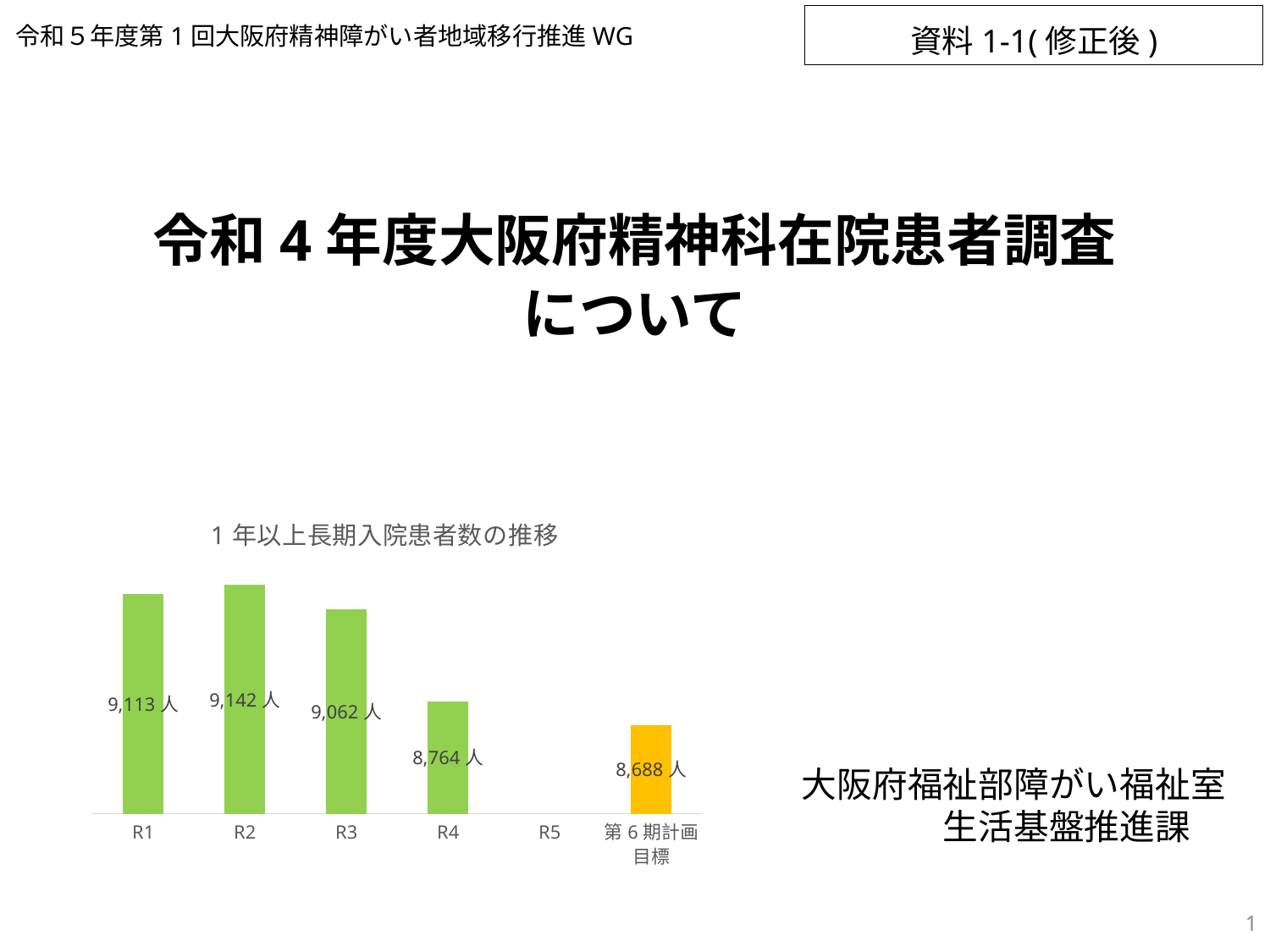
What kind of chart is shown on the slide? Bar chart What is the value shown for 第6期計画目標 in the chart? 8,688人 Which category with a plotted bar has the lowest value in the chart? 第6期計画目標 What is the value for R2 in the chart? 9,142人 What is the value for R1 in the chart? 9,113人 Which category has the highest value in the chart? R2 What is the title of the chart? 1年以上長期入院患者数の推移 How many bars are plotted in the chart? 5 What is the value for R4 in the chart? 8,764人 Which is larger, the value for R1 or the value for R3? R1 What is the difference between the values for R3 and R4? 298人 What is the value for R3 in the chart? 9,062人